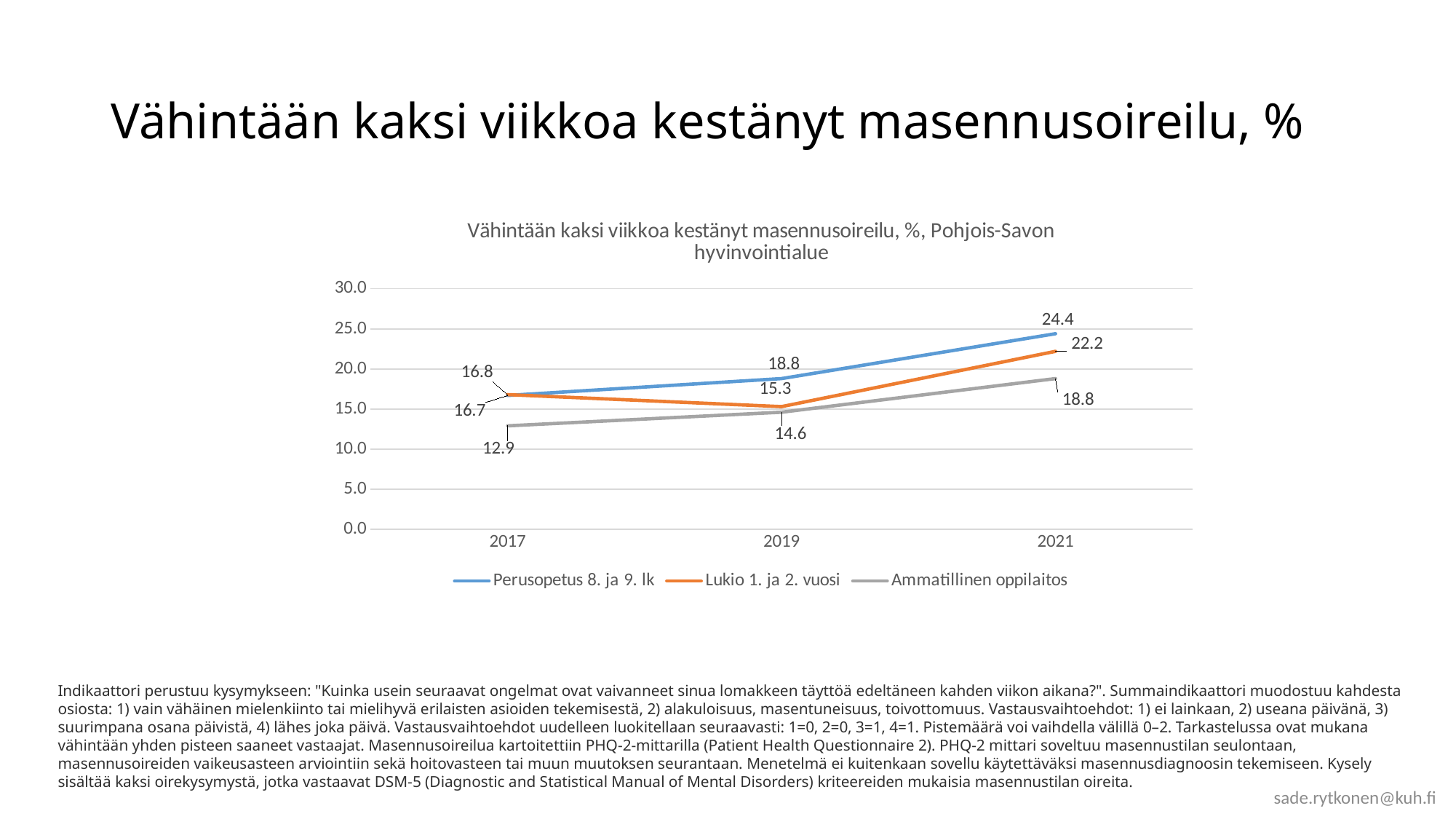
What is the difference between the Perusopetus 8. ja 9. lk value and the Lukio 1. ja 2. vuosi value in 2021? 2.2 What is the value for Perusopetus 8. ja 9. lk in 2021? 24.4 What is the value for Ammatillinen oppilaitos in 2021? 18.8 What is the value for Lukio 1. ja 2. vuosi in 2019? 15.3 Which is larger in 2019: the value for Lukio 1. ja 2. vuosi or the value for Ammatillinen oppilaitos? Lukio 1. ja 2. vuosi How many years are shown on the x axis? 3 What type of chart is shown on the slide? line chart How many series does the legend list? 3 Which series has the highest value in 2019? Perusopetus 8. ja 9. lk Which series has the lowest value in 2021? Ammatillinen oppilaitos Does the value for Ammatillinen oppilaitos rise or fall from 2017 to 2021? rise What is the value for Ammatillinen oppilaitos in 2017? 12.9